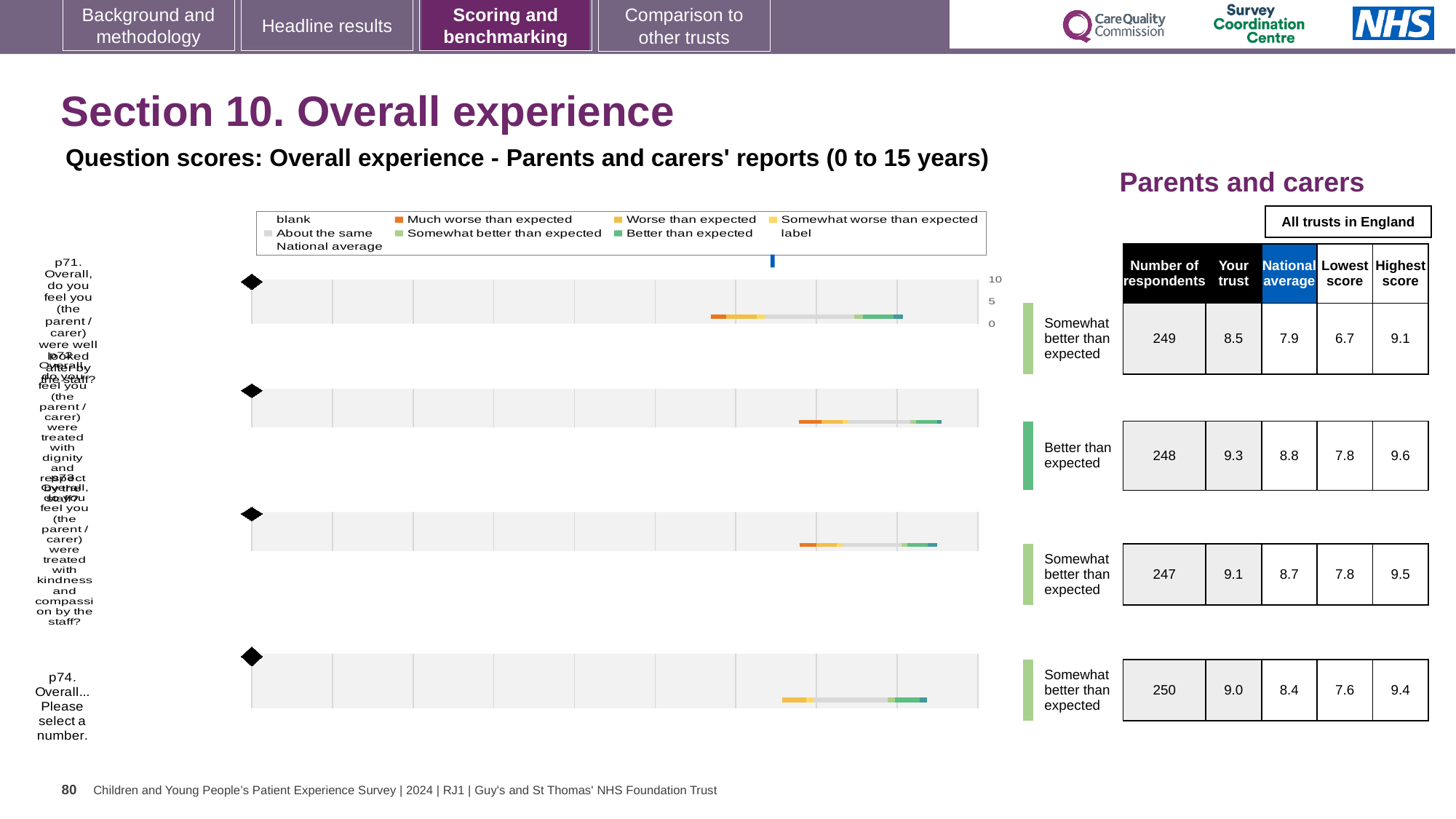
What is the 'Your trust' score for p74 (Overall... Please select a number)? 9.0 Which benchmark category is p72 placed in? Better than expected What is the difference between the trust score and the national average for p72? 0.5 What is the highest score across all trusts in England for p74? 9.4 What is the national average score for p71? 7.9 Which question has the lowest 'Your trust' score? p71 How many questions (bars) are plotted in the chart? 4 How many respondents answered p72? 248 Which is larger for p73: the trust score or the national average? the trust score What kind of chart is shown on the slide? bar chart What is the subtitle of the chart? Question scores: Overall experience - Parents and carers' reports (0 to 15 years) Which question has the highest 'Your trust' score? p72